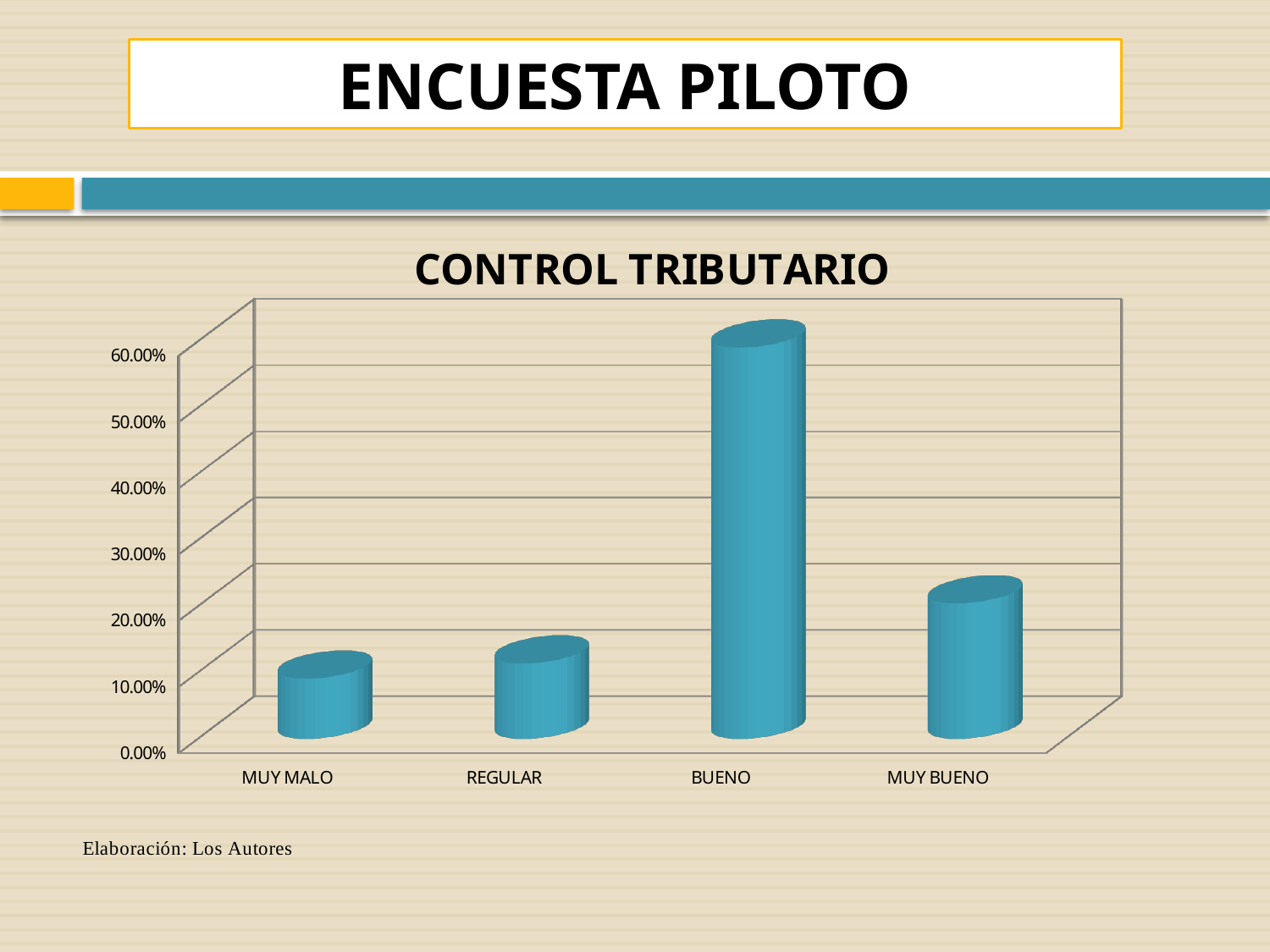
Which category has the highest value in the chart? BUENO Is the value for REGULAR greater or less than 20.00%? less What kind of chart is shown on the slide? bar chart What is the title of the chart? CONTROL TRIBUTARIO Is the value for MUY BUENO greater or less than 10.00%? greater Is the value for MUY BUENO greater or less than 30.00%? less Which is larger, the value for MUY BUENO or the value for REGULAR? MUY BUENO How many categories are shown on the x axis of the chart? 4 What is the source note printed below the chart? Elaboración: Los Autores Which is larger, the value for BUENO or the value for MUY BUENO? BUENO